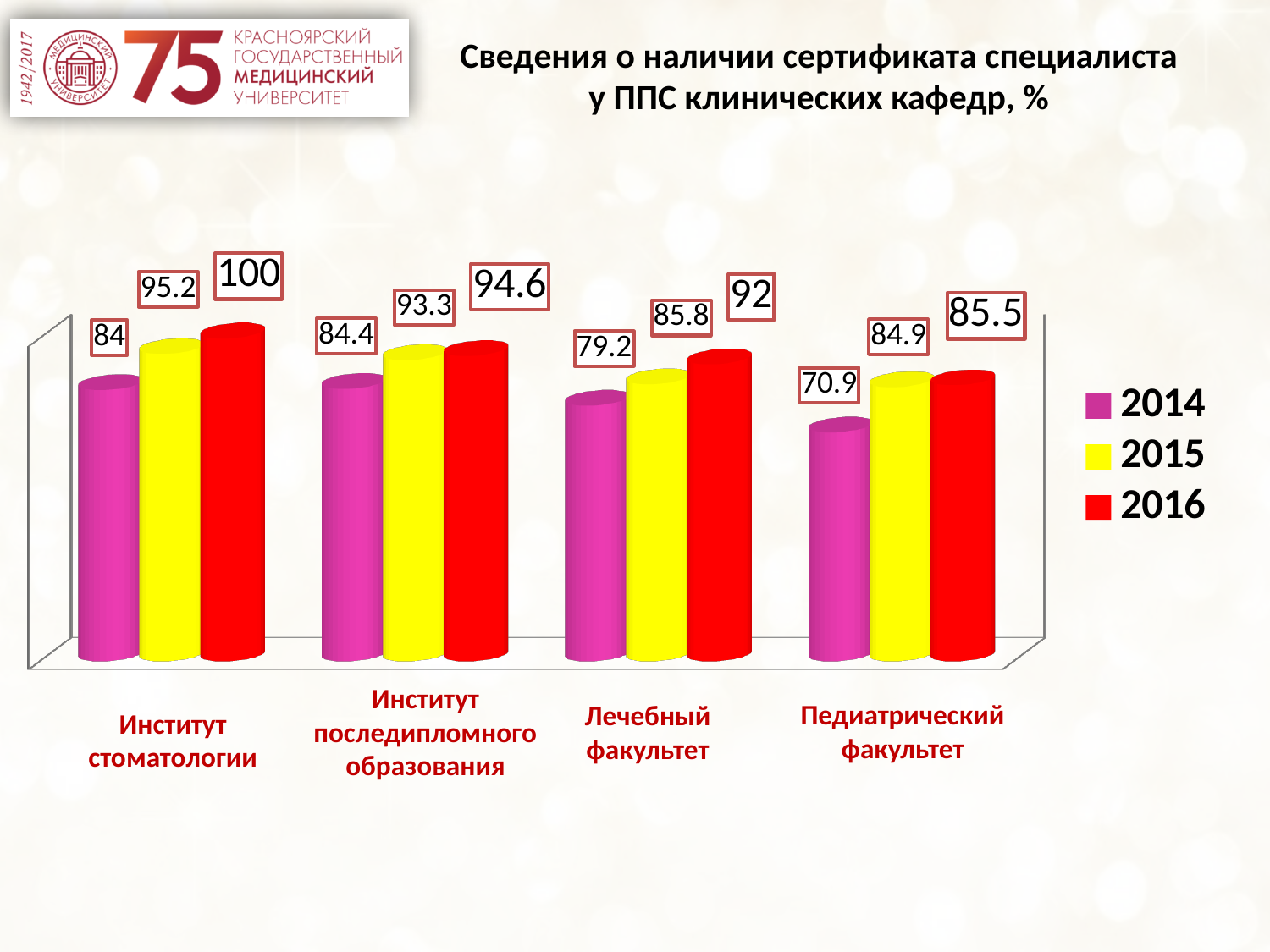
What is the value for Педиатрический факультет in 2014? 70.9 What kind of chart is shown on the slide? Bar chart Which category has the highest value in 2016? Институт стоматологии What is the difference between the 2016 and 2014 values for Педиатрический факультет? 14.6 How many categories are shown on the x axis? 4 What is the value for Институт стоматологии in 2016? 100 How many series does the legend list? 3 What is the value for Лечебный факультет in 2015? 85.8 Which is larger: the 2015 value for Институт стоматологии or the 2015 value for Институт последипломного образования? Институт стоматологии Which category has the lowest value in 2014? Педиатрический факультет What is the value for Институт последипломного образования in 2016? 94.6